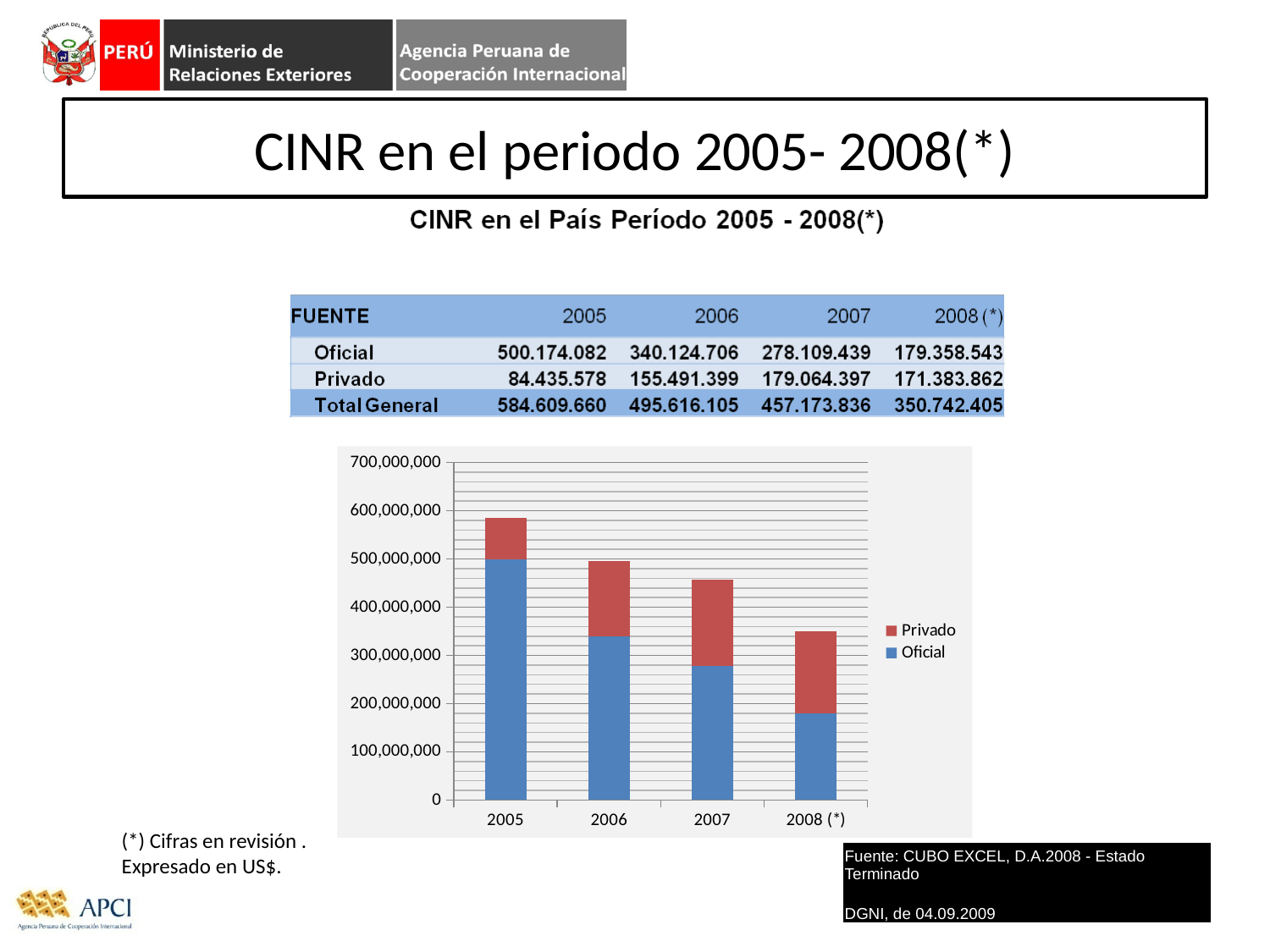
What is the Total General for 2008 (*)? 350.742.405 Is the Oficial value for 2006 larger or smaller than the Privado value for 2006? larger What is the Privado value for 2007? 179.064.397 How many series does the chart legend list? 2 Which year has the lowest Oficial value? 2008 (*) What kind of chart is shown on the slide? Stacked bar chart What is the Oficial value for 2005? 500.174.082 Which colour represents the Privado series in the chart? Red Do the total bar heights rise or fall from 2005 to 2008 (*)? fall Is the total bar for 2007 greater or less than 400,000,000? greater Which year has the highest Total General? 2005 How many years are shown on the x axis of the chart? 4